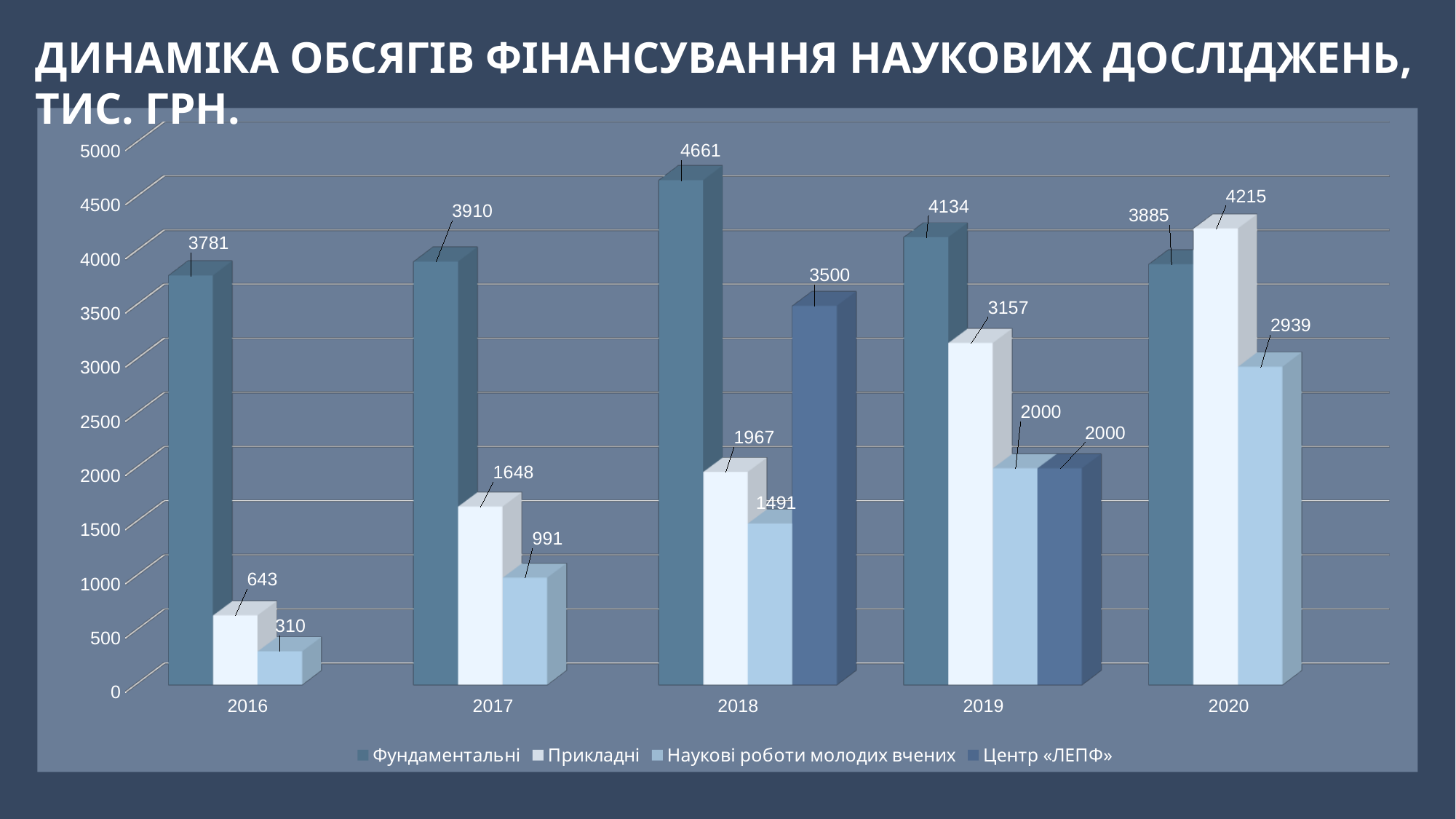
What is the value for Фундаментальні in 2018? 4661 What kind of chart is shown on the slide? Bar chart What is the difference between the Фундаментальні value in 2018 and in 2017? 751 In which year is the value for Фундаментальні highest? 2018 Which is larger in 2020: Фундаментальні or Прикладні? Прикладні What is the value for Центр «ЛЕПФ» in 2018? 3500 How many series does the legend list? 4 What is the value for Наукові роботи молодих вчених in 2016? 310 Do the values for Прикладні rise or fall from 2016 to 2020? Rise How many years are shown on the x axis? 5 In which year is the value for Прикладні lowest? 2016 What is the value for Прикладні in 2020? 4215